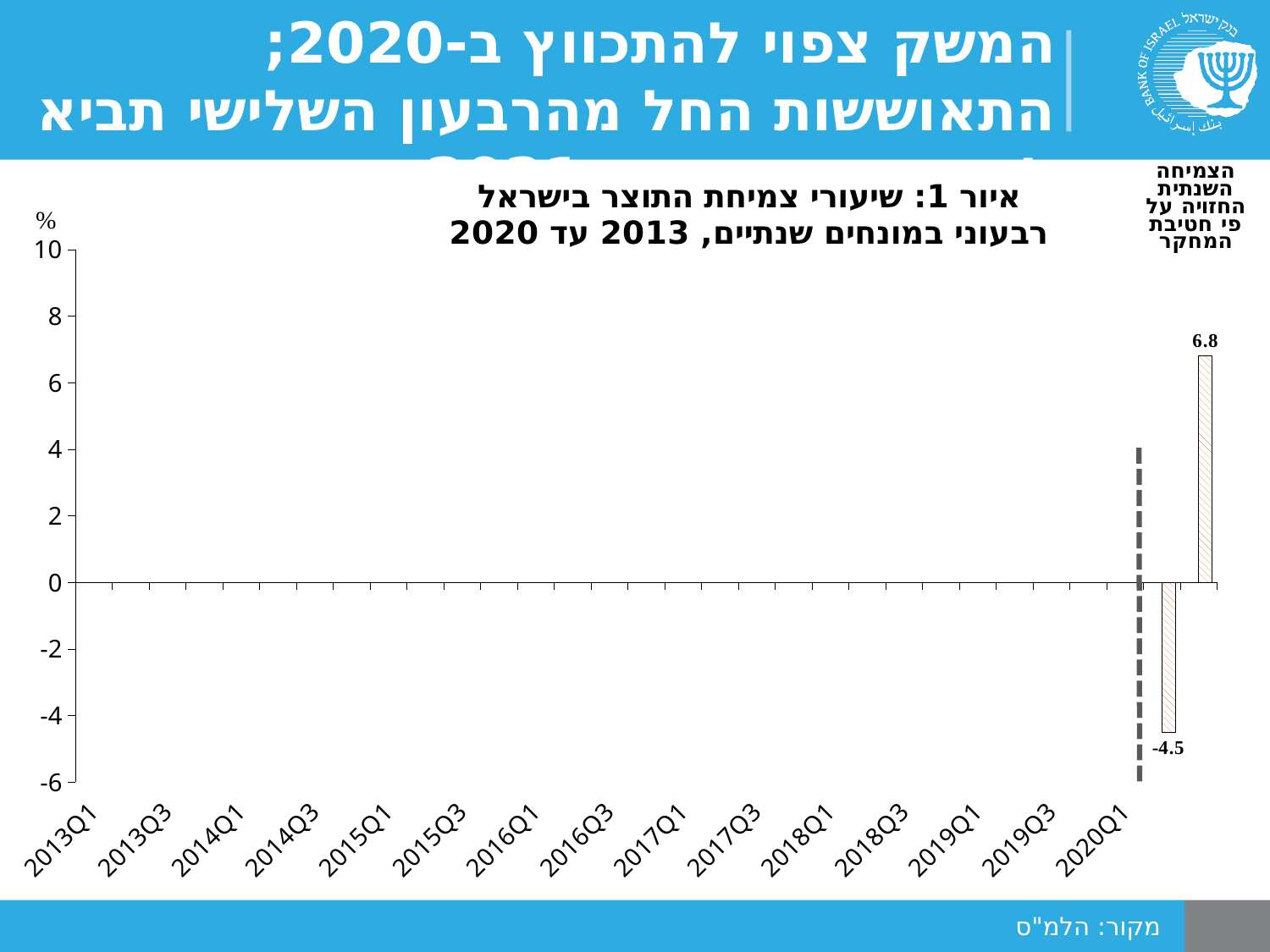
What is the lowest value labeled on the chart? -4.5 What is the first label on the x axis? 2013Q1 What is the difference between the two labeled bar values, 6.8 and -4.5? 11.3 How many bars are plotted on the chart? 2 What unit is shown at the top of the y axis? % Is the value of the positive bar greater or less than 6? greater What kind of chart is shown on the slide? bar chart What is the value printed on the negative bar at the right of the chart? -4.5 Which of the two labeled bars has the larger value, the one labeled 6.8 or the one labeled -4.5? 6.8 Is the value of the negative bar greater or less than -4? less What is the highest value labeled on the chart? 6.8 What is the value printed on the positive bar at the right of the chart? 6.8